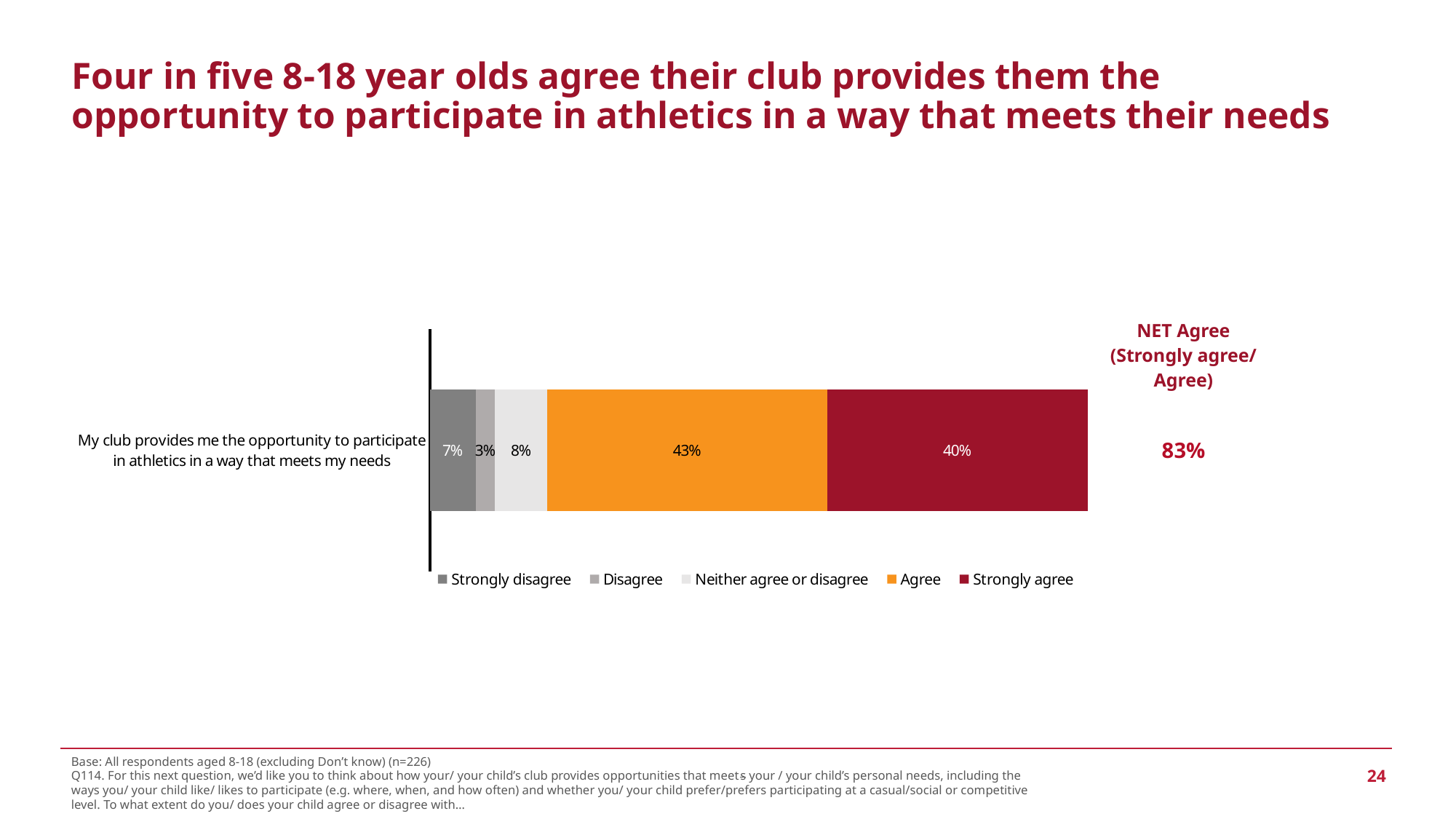
What percentage of respondents selected 'Neither agree or disagree'? 8% Which response category has the largest share of the bar? Agree What kind of chart is shown on the slide? Stacked horizontal bar chart Which is larger, the share for 'Neither agree or disagree' or the share for 'Strongly disagree'? Neither agree or disagree What percentage of respondents selected 'Disagree'? 3% Which response category has the smallest share of the bar? Disagree What percentage of respondents selected 'Strongly agree'? 40% What percentage of respondents selected 'Agree'? 43% What is the difference in percentage points between 'Agree' and 'Strongly agree'? 3 percentage points What is the NET Agree (Strongly agree/Agree) figure shown on the slide? 83% How many series does the legend list? 5 What percentage of respondents selected 'Strongly disagree'? 7%